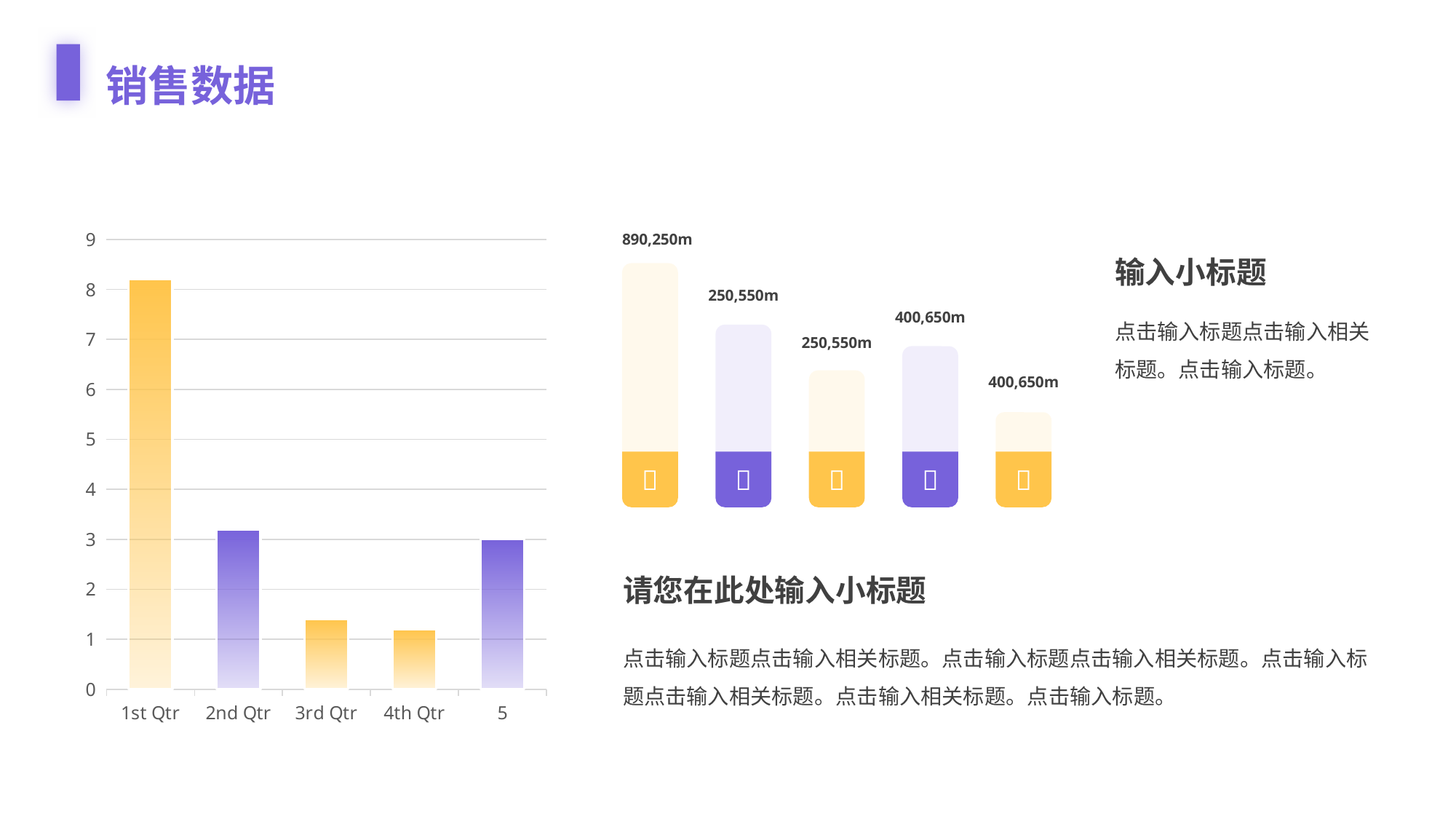
How many categories are shown on the x axis of the bar chart on the left? 5 In the bar chart on the left, which is larger, the value for 1st Qtr or the value for 2nd Qtr? 1st Qtr In the bar chart on the left, is the value for 2nd Qtr greater or less than 4? less In the bar chart on the left, is the value for 3rd Qtr greater or less than 2? less What kind of chart is shown on the left side of the slide? bar chart In the bar graphic on the right side of the slide, what value is printed above the first (leftmost) bar? 890,250m In the bar chart on the left, which is larger, the value for 4th Qtr or the value for the category labelled 5? 5 In the bar chart on the left, is the value for the category labelled 5 greater or less than 2? greater In the bar chart on the left, do the values rise or fall from 1st Qtr to 4th Qtr? fall In the bar chart on the left, which category has the highest value? 1st Qtr What is the highest tick value shown on the y axis of the bar chart on the left? 9